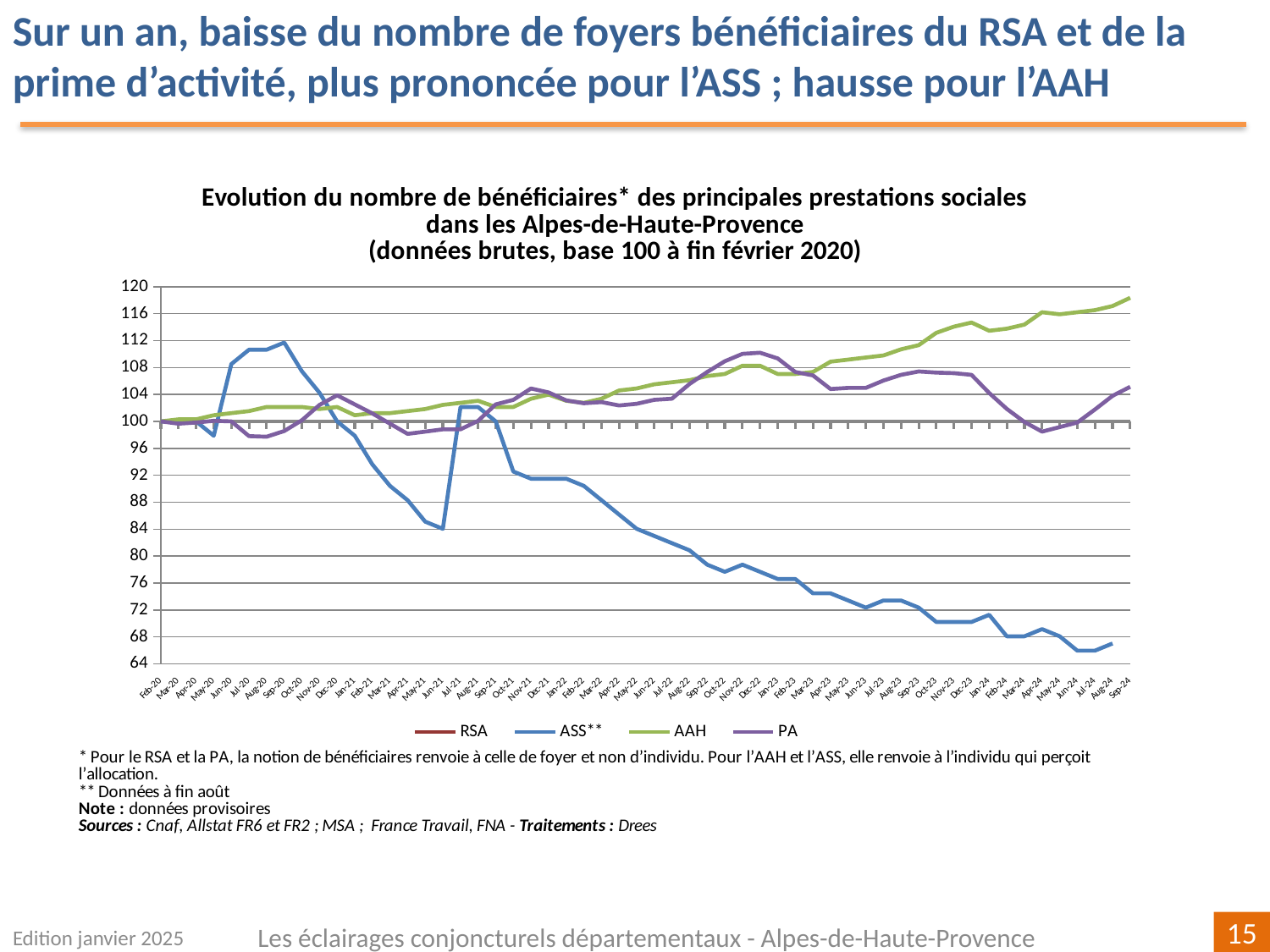
At Sep-24, which is larger, the value for AAH or the value for PA? AAH Does the ASS** series rise or fall overall between Sep-20 and Sep-24? fall Which series are listed in the legend? RSA, ASS**, AAH, PA Is the value for AAH at Sep-24 greater or less than 112? greater How many series does the legend list? 4 Which series has the highest value at Sep-24? AAH What kind of chart is shown on the slide? line chart Is the value for ASS** at Sep-20 greater or less than 108? greater What is the base value of the index at end of February 2020, according to the chart title? 100 Is the value for PA at Sep-24 greater or less than 100? greater